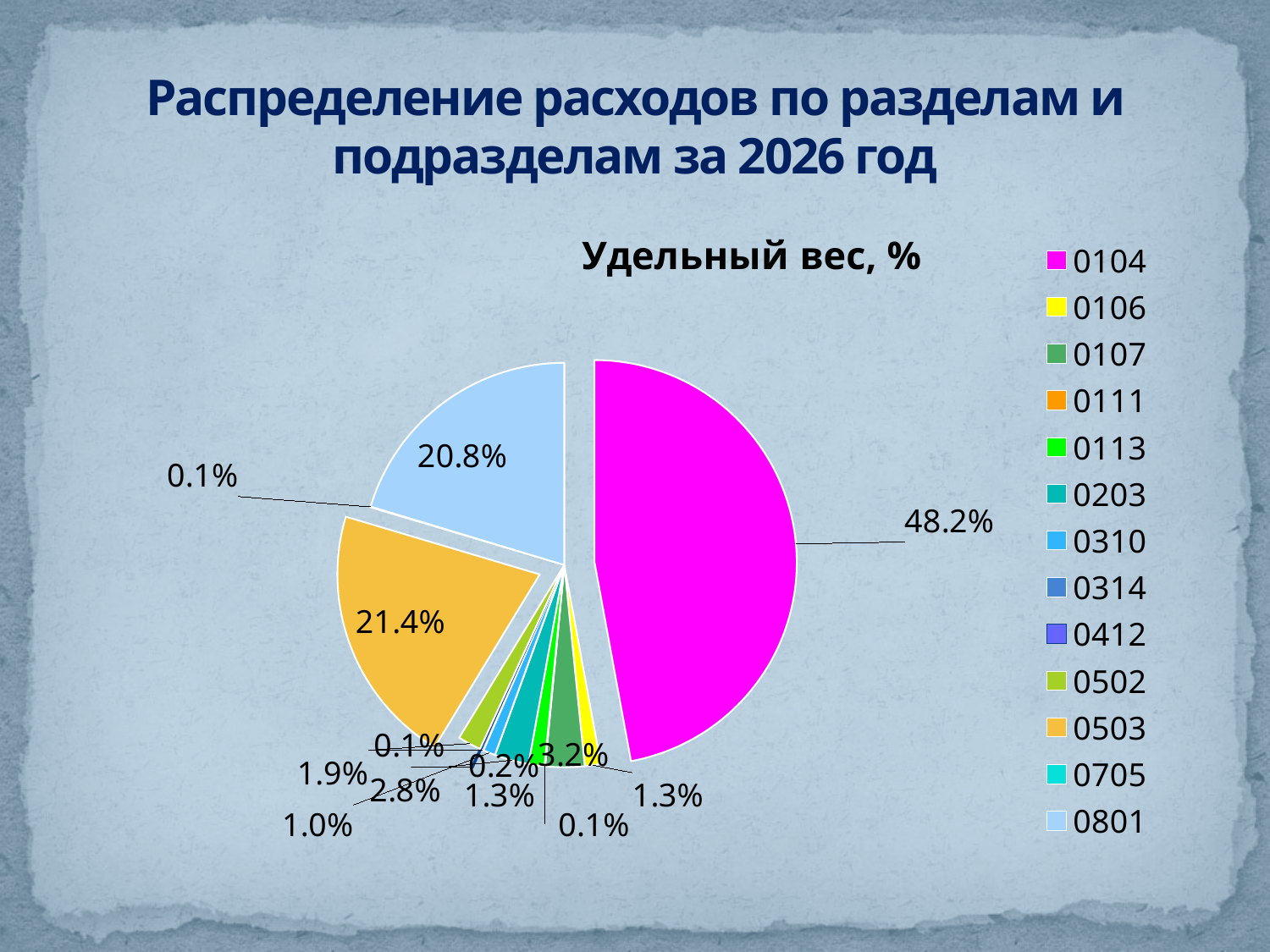
What share of the pie does section 0503 have? 21.4% What is the title of the chart? Удельный вес, % What share of the pie does section 0107 have? 3.2% What share of the pie does section 0801 have? 20.8% Which section has the largest slice of the pie? 0104 Which is larger, the share for 0503 or the share for 0801? 0503 What colour is the slice for section 0104? magenta How many entries does the chart legend list? 13 What kind of chart is shown on the slide? pie chart What is the difference between the share for 0503 and the share for 0801? 0.6% What is the difference between the share for 0104 and the share for 0503? 26.8%